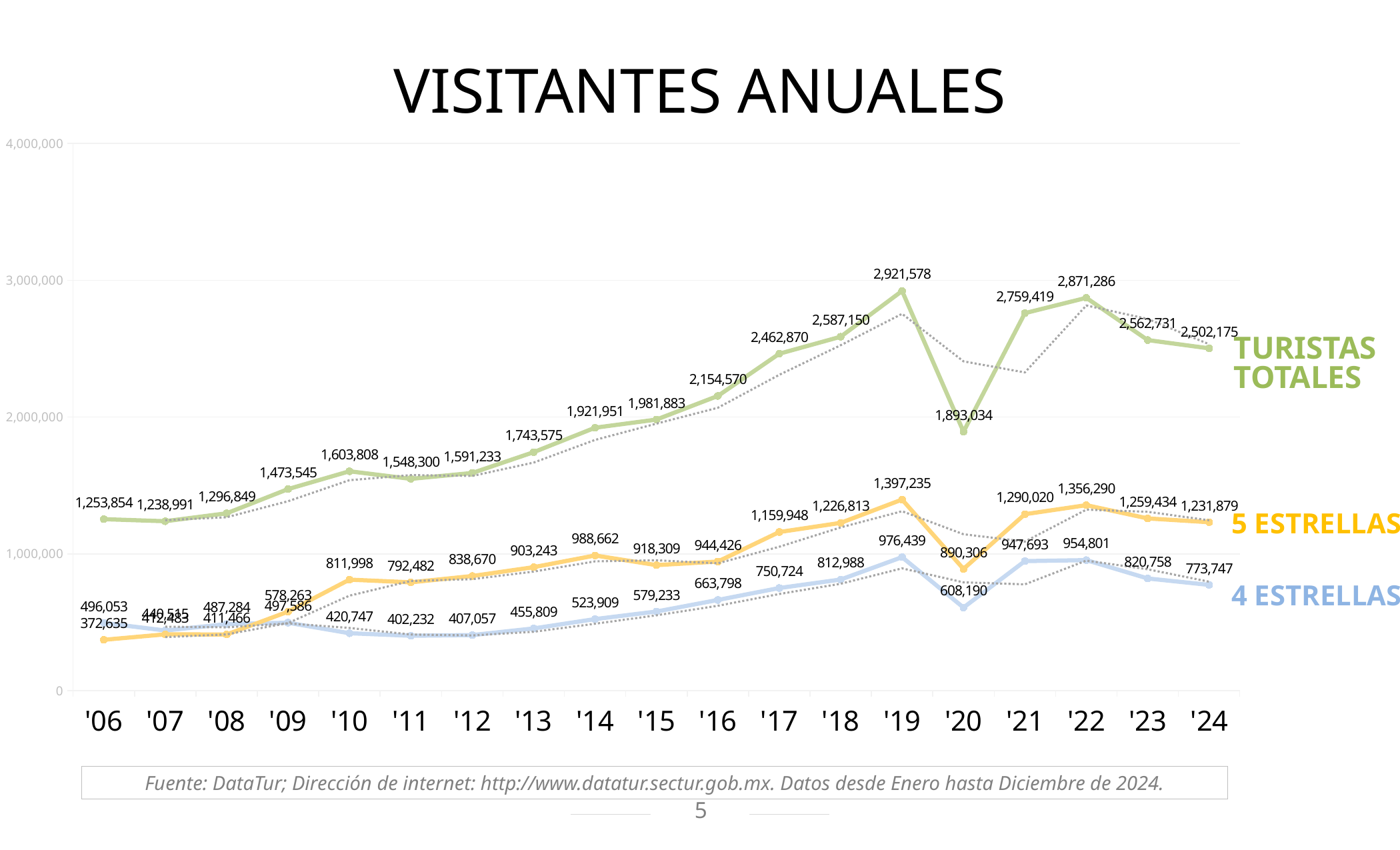
What is the value for 4 ESTRELLAS in '20? 608,190 What is the title of the chart? VISITANTES ANUALES How many years are shown on the x axis? 19 Is the TURISTAS TOTALES value in '20 greater or less than 2,000,000? less How many labelled series are plotted on the chart? 3 What kind of chart is shown on the slide? line chart In which year does TURISTAS TOTALES reach its highest value? '19 In which year is the 5 ESTRELLAS value lowest? '06 What is the value for TURISTAS TOTALES in '19? 2,921,578 What is the value for 5 ESTRELLAS in '24? 1,231,879 What is the difference between the TURISTAS TOTALES values in '19 and '20? 1,028,544 Which is larger in '22: the 5 ESTRELLAS value or the 4 ESTRELLAS value? 5 ESTRELLAS